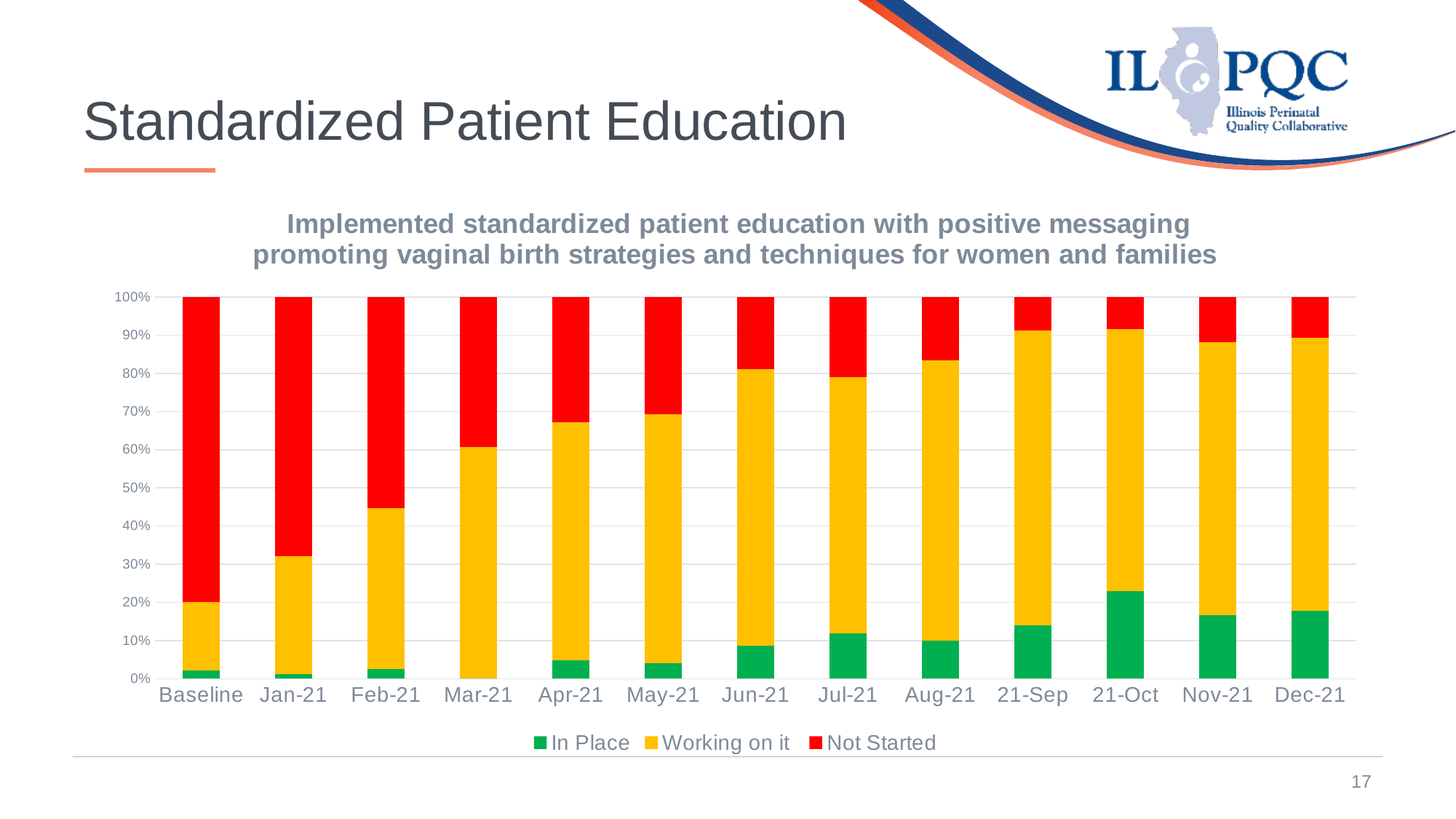
How many time periods (categories) are shown on the x axis? 13 Is the In Place value for Baseline greater or less than 10%? less Which category has the largest In Place share? 21-Oct What kind of chart is shown on the slide? Stacked bar chart How many series does the legend list? 3 Which category has the smallest In Place share? Mar-21 Which is larger, the In Place share for 21-Oct or for Nov-21? 21-Oct Is the In Place value for 21-Oct greater or less than 20%? greater Does the Not Started share generally rise or fall from Baseline to Dec-21? Fall Is the Working on it value for Mar-21 greater or less than 50%? greater Which series is shown in red in the legend? Not Started Which category has the largest Not Started share? Baseline